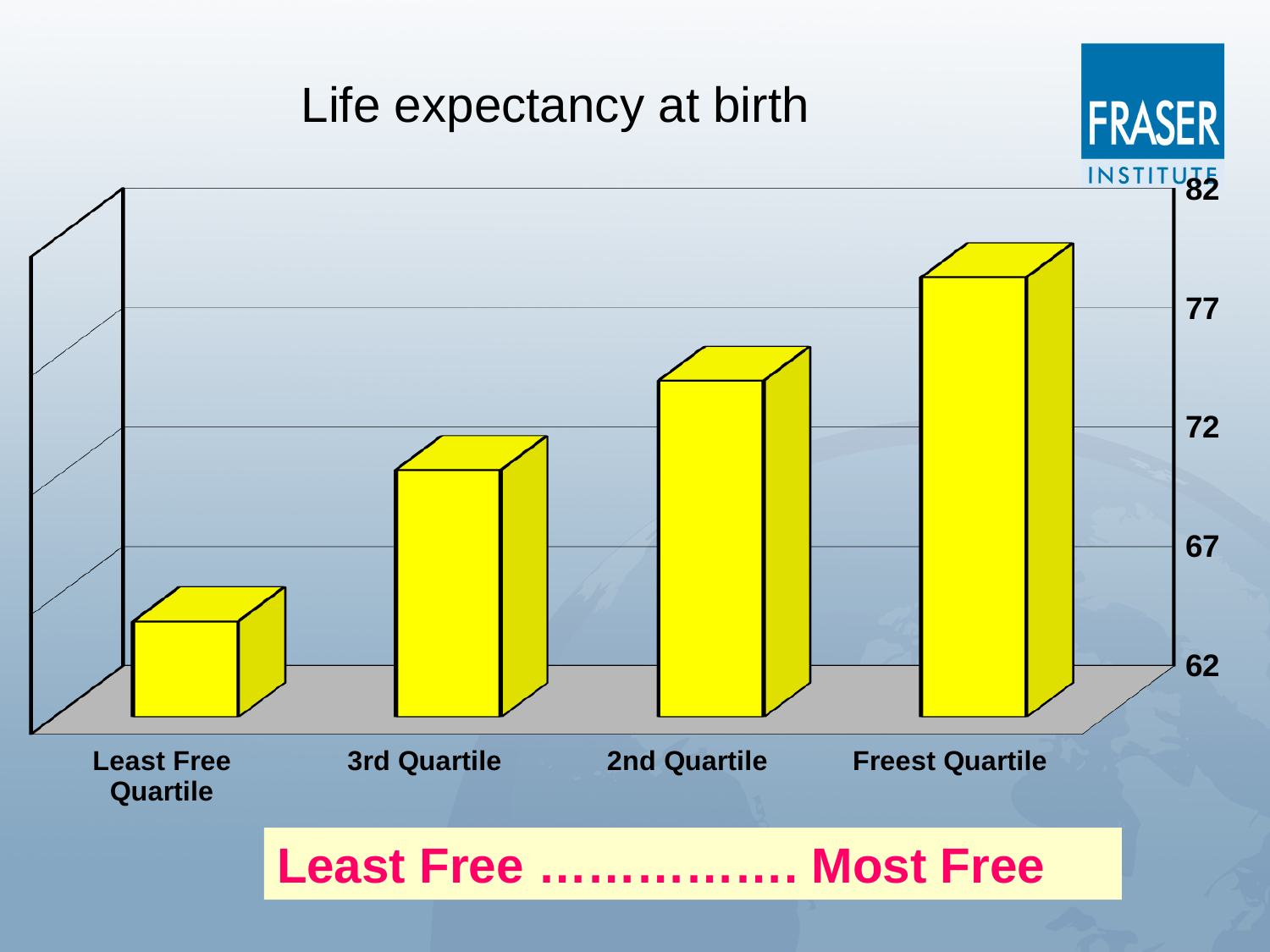
Is the value for the Freest Quartile greater or less than 77? greater Which is larger, the value for the 2nd Quartile or the 3rd Quartile? 2nd Quartile Is the value for the 2nd Quartile greater or less than 72? greater Is the value for the Least Free Quartile greater or less than 67? less Which category has the highest life expectancy at birth? Freest Quartile What kind of chart is shown on the slide? Bar chart Which category has the lowest life expectancy at birth? Least Free Quartile What is the title of the chart? Life expectancy at birth How many categories are plotted in the chart? 4 Do the values rise or fall moving from the Least Free Quartile to the Freest Quartile? rise